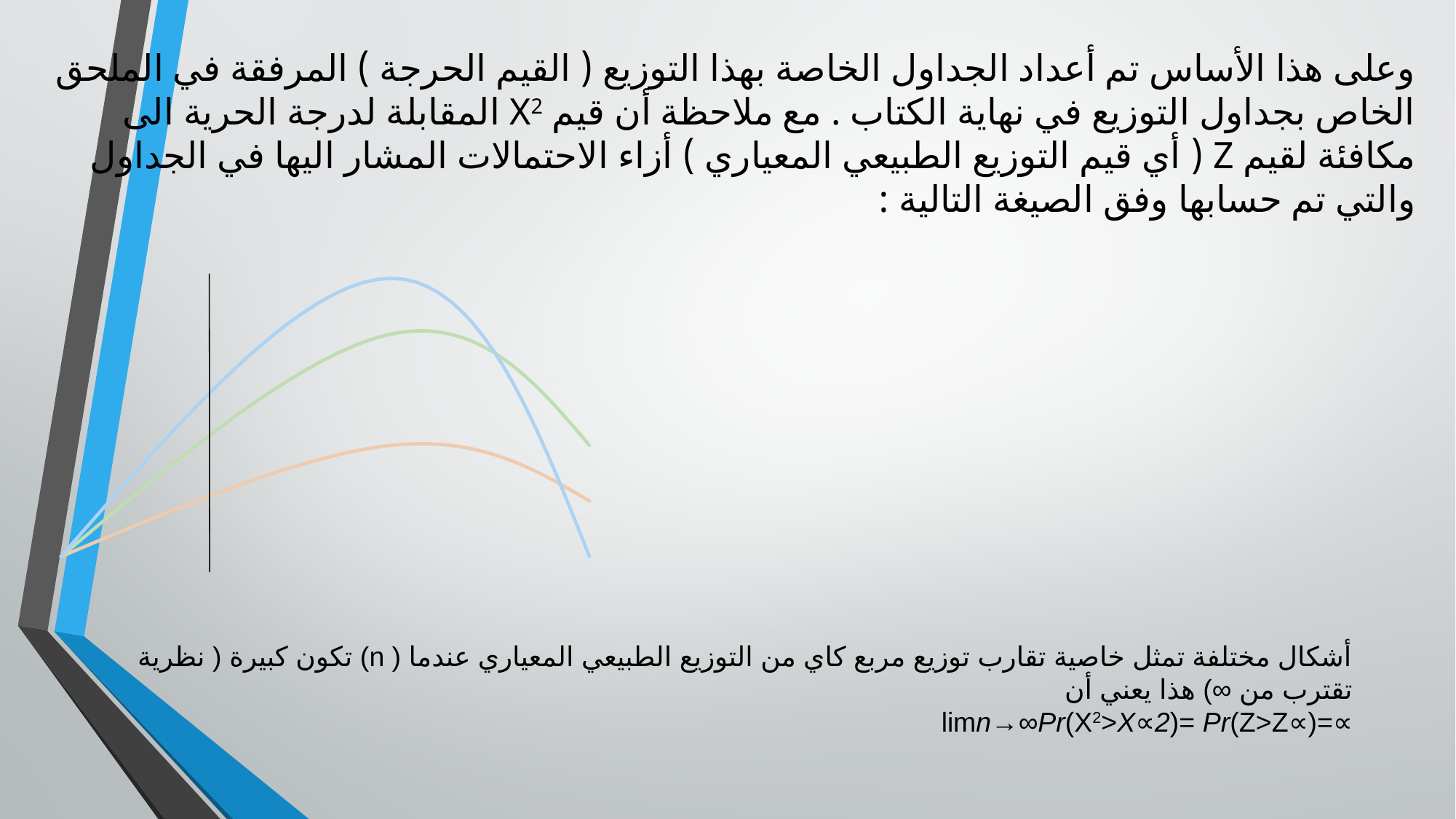
Do the curves rise and then fall as they move from left to right? yes Which coloured curve ends lowest at the right-hand side of the chart? blue Which coloured curve has the lowest peak on the chart? orange Which coloured curve reaches the highest peak on the chart? blue What are the colours of the three curves on the chart? blue, green and orange What kind of chart is shown on the slide? line chart Does the chart display a legend? no Does the green curve or the orange curve reach a higher peak? green Does the blue curve or the orange curve reach a higher peak? blue How many curves are plotted on the chart? 3